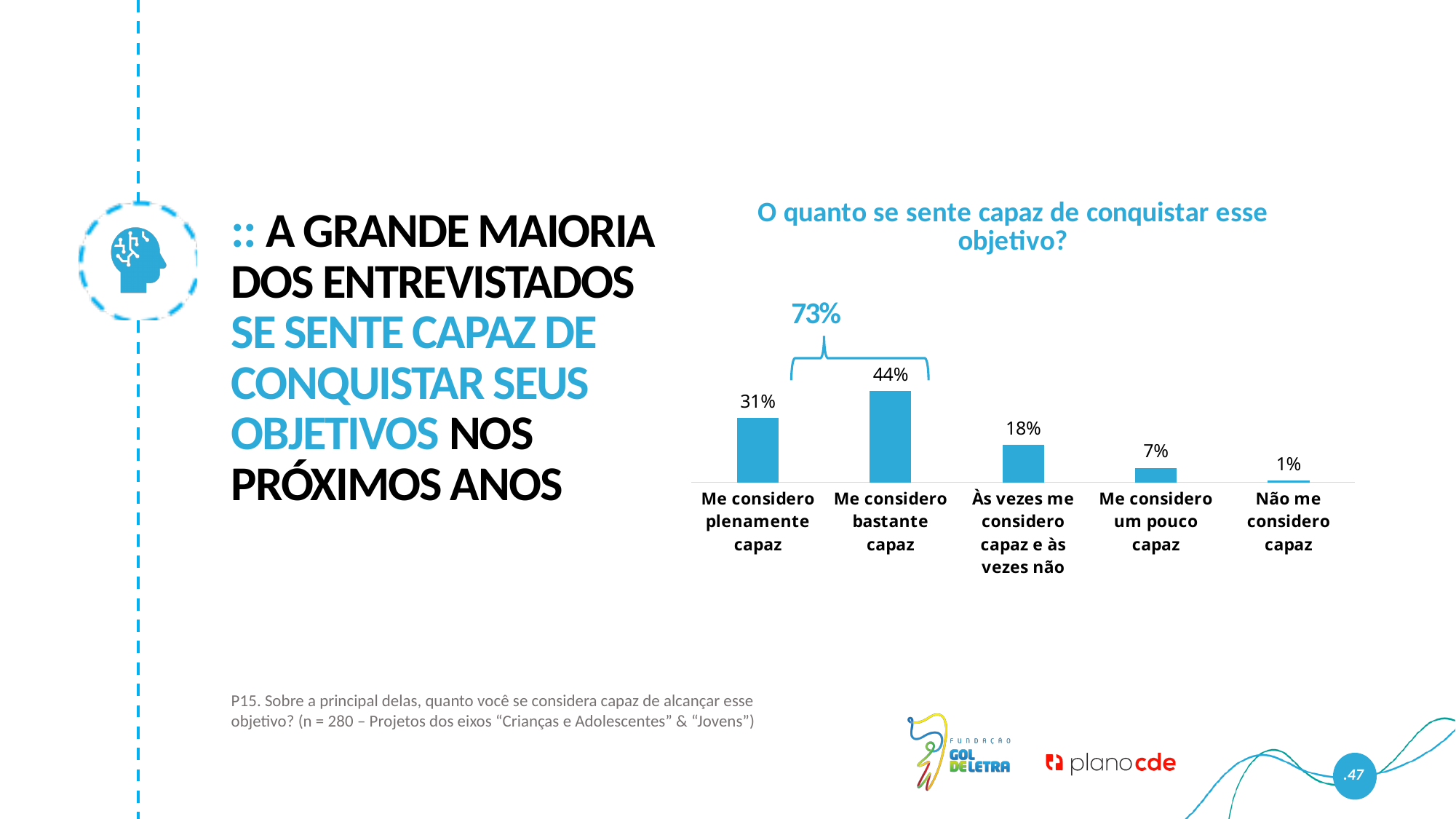
What is the value for "Às vezes me considero capaz e às vezes não"? 18% What is the title of the chart? O quanto se sente capaz de conquistar esse objetivo? What kind of chart is shown on the slide? Bar chart What is the value for "Não me considero capaz"? 1% What is the value for "Me considero bastante capaz"? 44% Which category has the highest value? Me considero bastante capaz How many categories are shown in the chart? 5 Which is larger: "Às vezes me considero capaz e às vezes não" or "Me considero um pouco capaz"? Às vezes me considero capaz e às vezes não What is the difference between "Me considero bastante capaz" and "Me considero plenamente capaz"? 13% What is the value for "Me considero plenamente capaz"? 31% Which category has the lowest value? Não me considero capaz What combined percentage does the bracket above the first two bars indicate? 73%